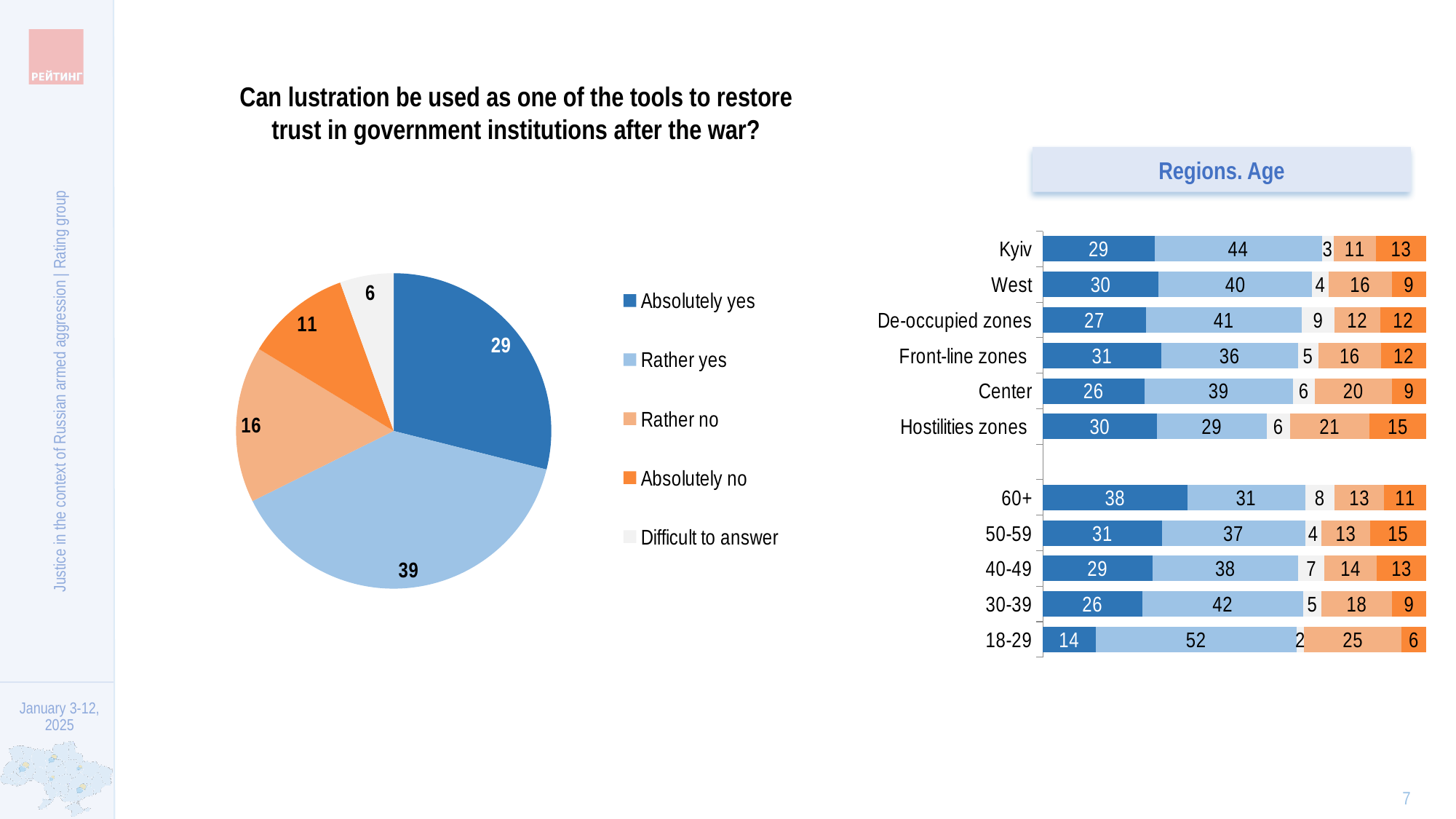
In the 'Regions. Age' chart, which age group has the highest 'Absolutely yes' (dark blue) value? 60+ In the pie chart, what percentage of respondents answered 'Rather yes'? 39 In the 'Regions. Age' chart, what is the 'Rather yes' (light blue) value for the 18-29 age group? 52 How many entries does the legend of the pie chart list? 5 What kind of chart is the chart on the left of the slide? Pie chart How many categories (regions and age groups) are shown in the 'Regions. Age' chart? 11 In the 'Regions. Age' chart, what is the 'Absolutely yes' (dark blue) value for the 18-29 age group? 14 In the 'Regions. Age' chart, which has the larger 'Rather yes' (light blue) value, Kyiv or West? Kyiv In the pie chart, what is the difference between the 'Absolutely yes' value and the 'Rather no' value? 13 In the pie chart, which answer has the largest slice? Rather yes What kind of chart is the 'Regions. Age' chart? Stacked bar chart In the pie chart, which answer has the smallest slice? Difficult to answer